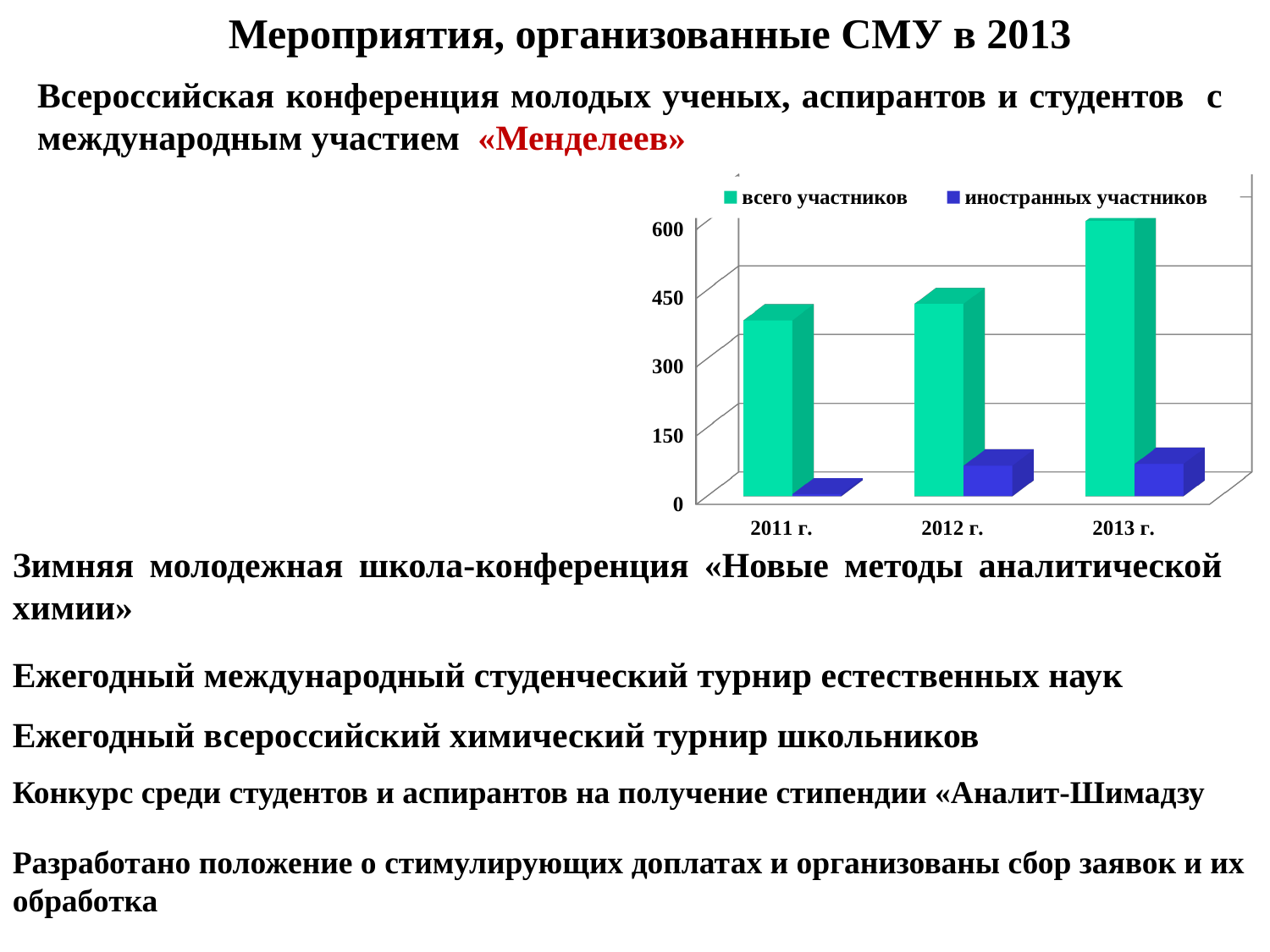
Is the value for «иностранных участников» in 2013 г. greater or less than 150? less In which year is the value for «иностранных участников» the lowest? 2011 г. In which year is the value for «всего участников» the lowest? 2011 г. What kind of chart is shown on the slide? bar chart How many series does the chart legend list? 2 Which year has the larger value for «всего участников», 2011 г. or 2013 г.? 2013 г. Is the value for «всего участников» in 2013 г. greater or less than 450? greater In which year is the value for «всего участников» the highest? 2013 г. Is the value for «всего участников» in 2012 г. greater or less than 300? greater Do the values for «всего участников» rise or fall from 2011 г. to 2013 г.? rise How many years (categories) are shown on the x axis of the chart? 3